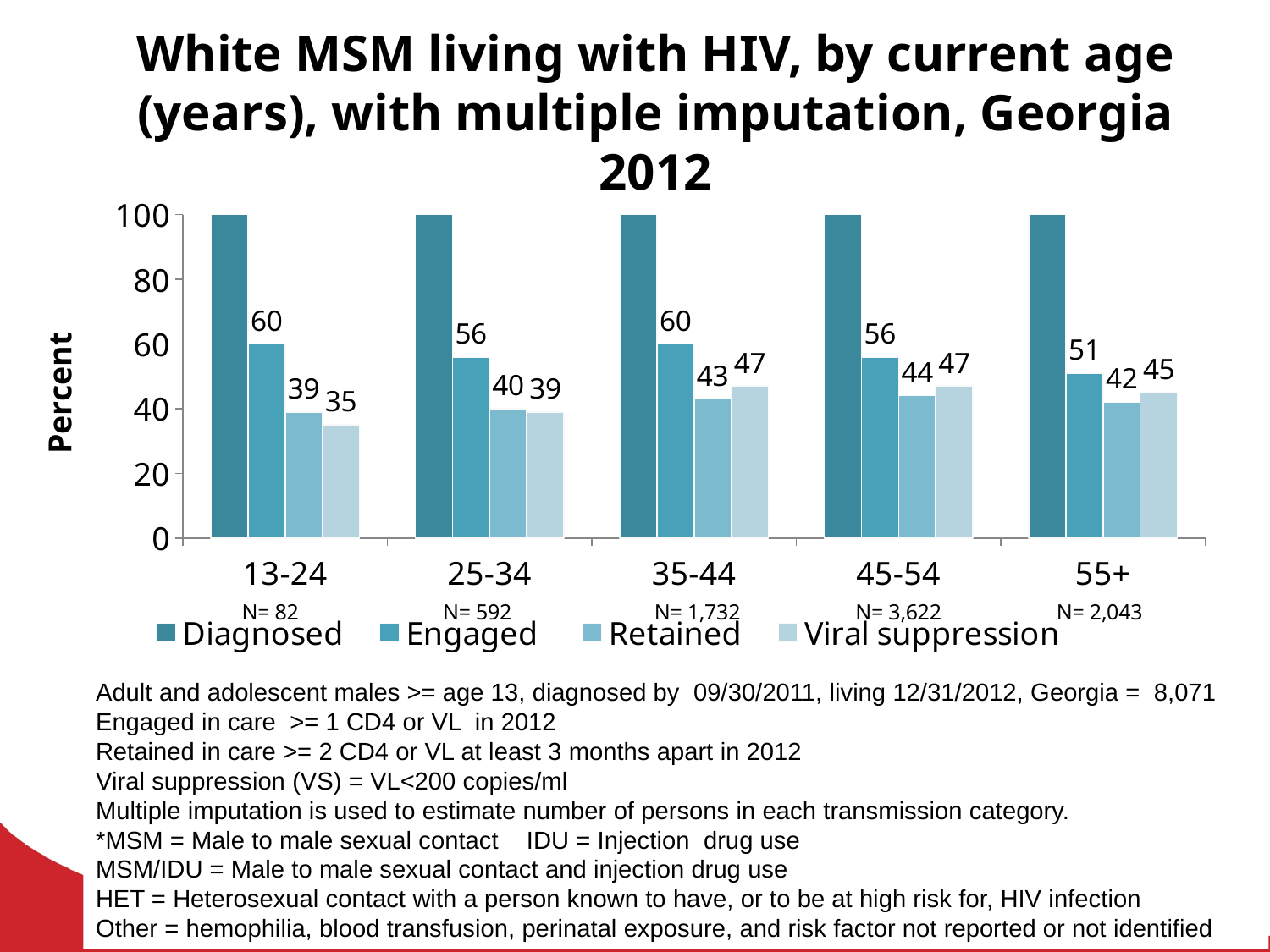
Which age group has the lowest Engaged value? 55+ What is the difference between the Engaged and Retained values for the 25-34 age group? 16 What is the Retained value for the 45-54 age group? 44 How many age groups are shown on the x axis? 5 What is the label of the y axis? Percent What is the Viral suppression value for the 55+ age group? 45 What is the Engaged value for the 13-24 age group? 60 What kind of chart is shown on the slide? Bar chart Which is larger for the 35-44 age group, the Retained value or the Viral suppression value? Viral suppression Which age group has the lowest Viral suppression value? 13-24 How many series does the legend list? 4 Is the Diagnosed value for the 45-54 age group greater or less than 80? greater